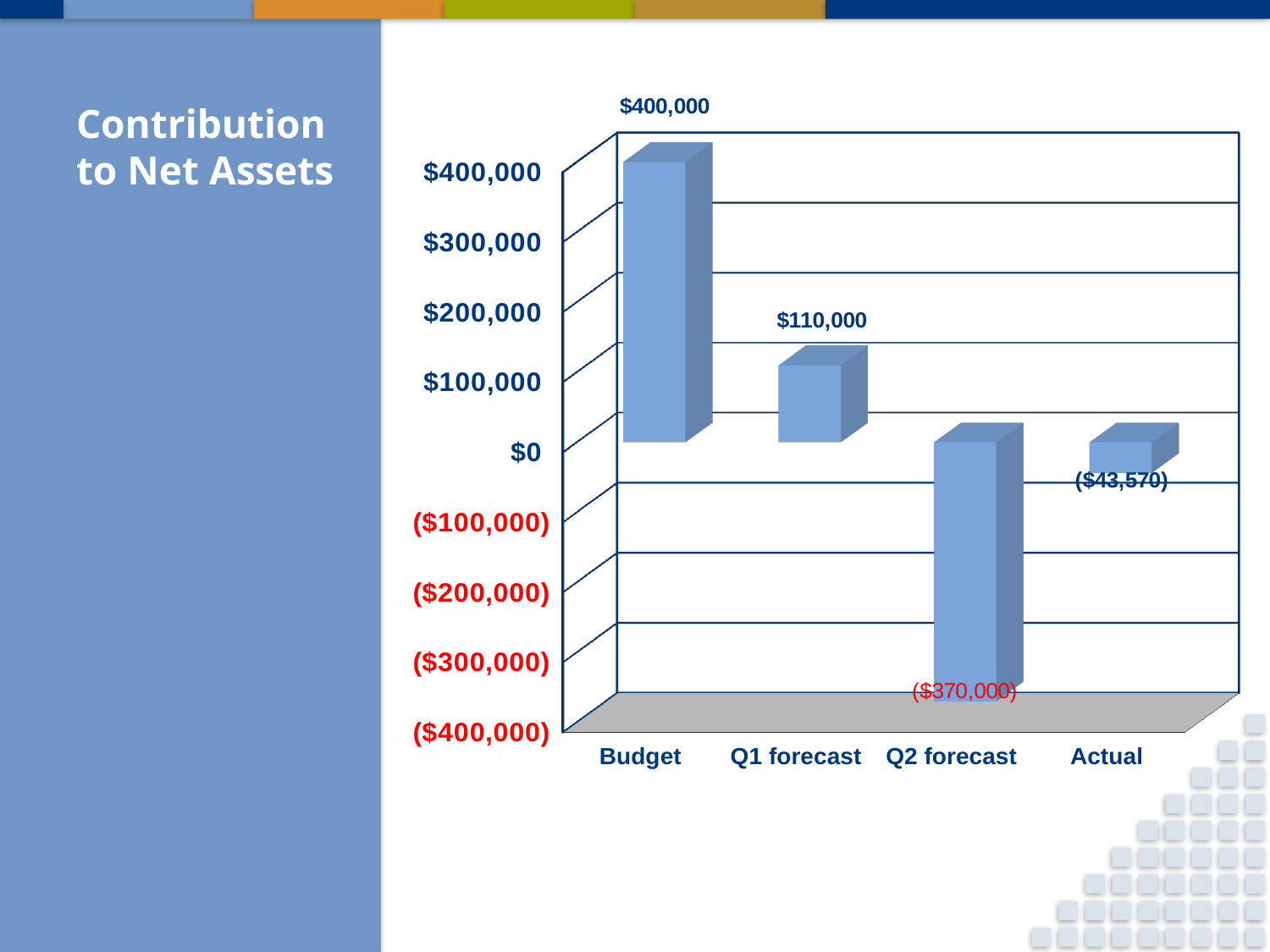
What is the value for Actual? ($43,570) How many categories are shown on the x axis? 4 What is the value for Budget? $400,000 Which category has the lowest value? Q2 forecast What is the value for Q1 forecast? $110,000 What is the title of the slide containing the chart? Contribution to Net Assets What kind of chart is shown on the slide? bar chart What is the difference between the Budget value and the Q1 forecast value? $290,000 Which category has the highest value? Budget Is the value for Q2 forecast greater or less than ($300,000)? less What is the value for Q2 forecast? ($370,000) Which is larger, the value for Q1 forecast or the value for Actual? Q1 forecast